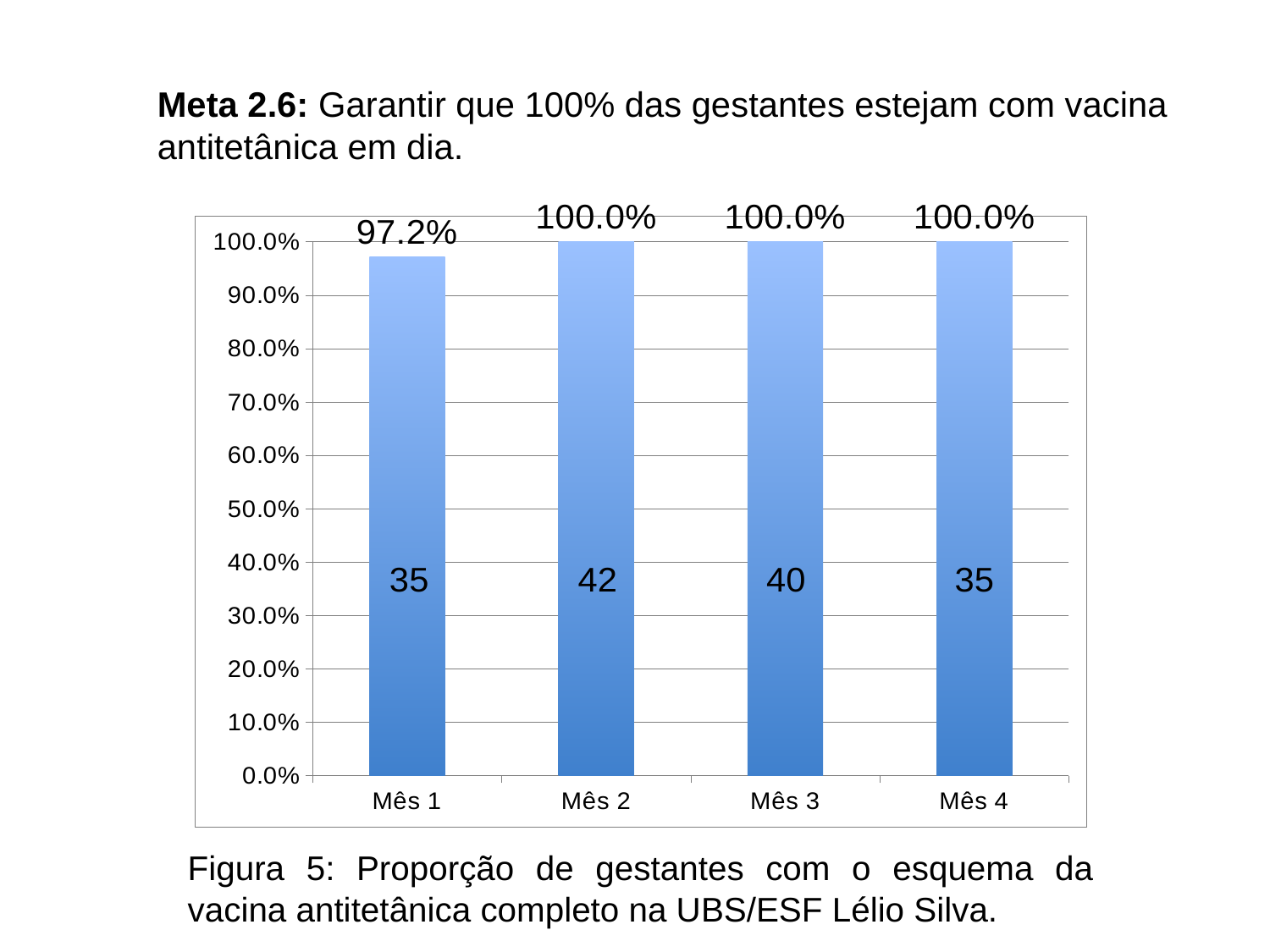
Is the value for Mês 1 greater or less than 90.0%? greater Which month has the lowest percentage value? Mês 1 What is the percentage value shown for Mês 1? 97.2% How many months (categories) are shown on the x axis? 4 What number is printed inside the bar for Mês 4? 35 What is the percentage value shown for Mês 3? 100.0% What number is printed inside the bar for Mês 2? 42 Which is larger, the percentage value for Mês 1 or for Mês 2? Mês 2 What kind of chart is shown on the slide? Bar chart What is the difference between the numbers printed inside the bars for Mês 2 and Mês 3? 2 What is the difference between the percentage values for Mês 2 and Mês 1? 2.8% What is the figure number given in the caption below the chart? Figura 5